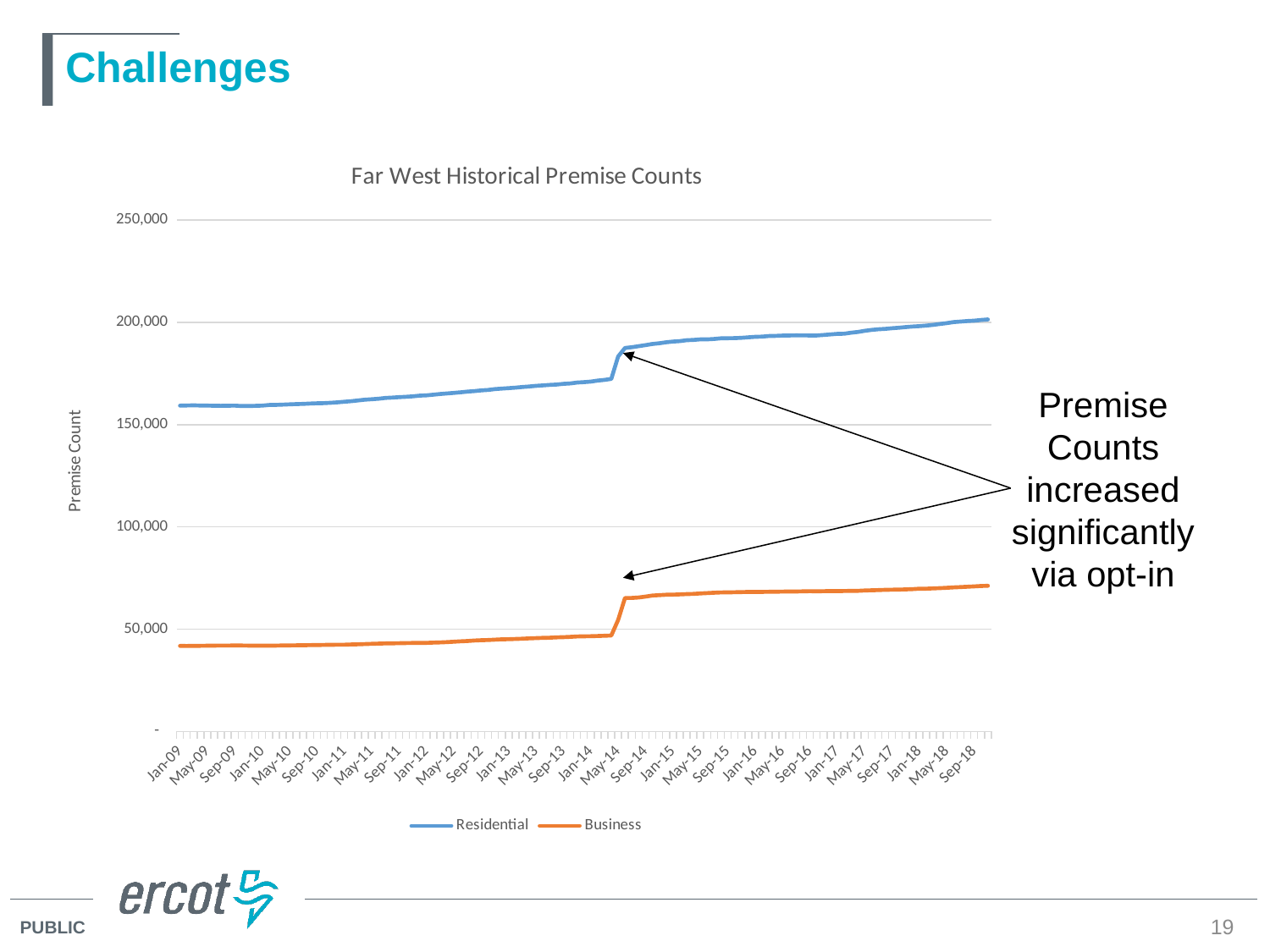
Does the Residential series rise or fall from Jan-09 to Sep-18? rise Is the Residential value at Jan-14 greater or less than 200,000? less Does the Business series rise or fall from Jan-09 to Sep-18? rise Which series is drawn in orange? Business What is the title of the chart? Far West Historical Premise Counts Is the Residential value at Jan-09 greater or less than 150,000? greater Which series has the higher premise count throughout the chart, Residential or Business? Residential How many series does the legend list? 2 Is the Business value at Jan-16 greater or less than 100,000? less What kind of chart is shown on the slide? line chart